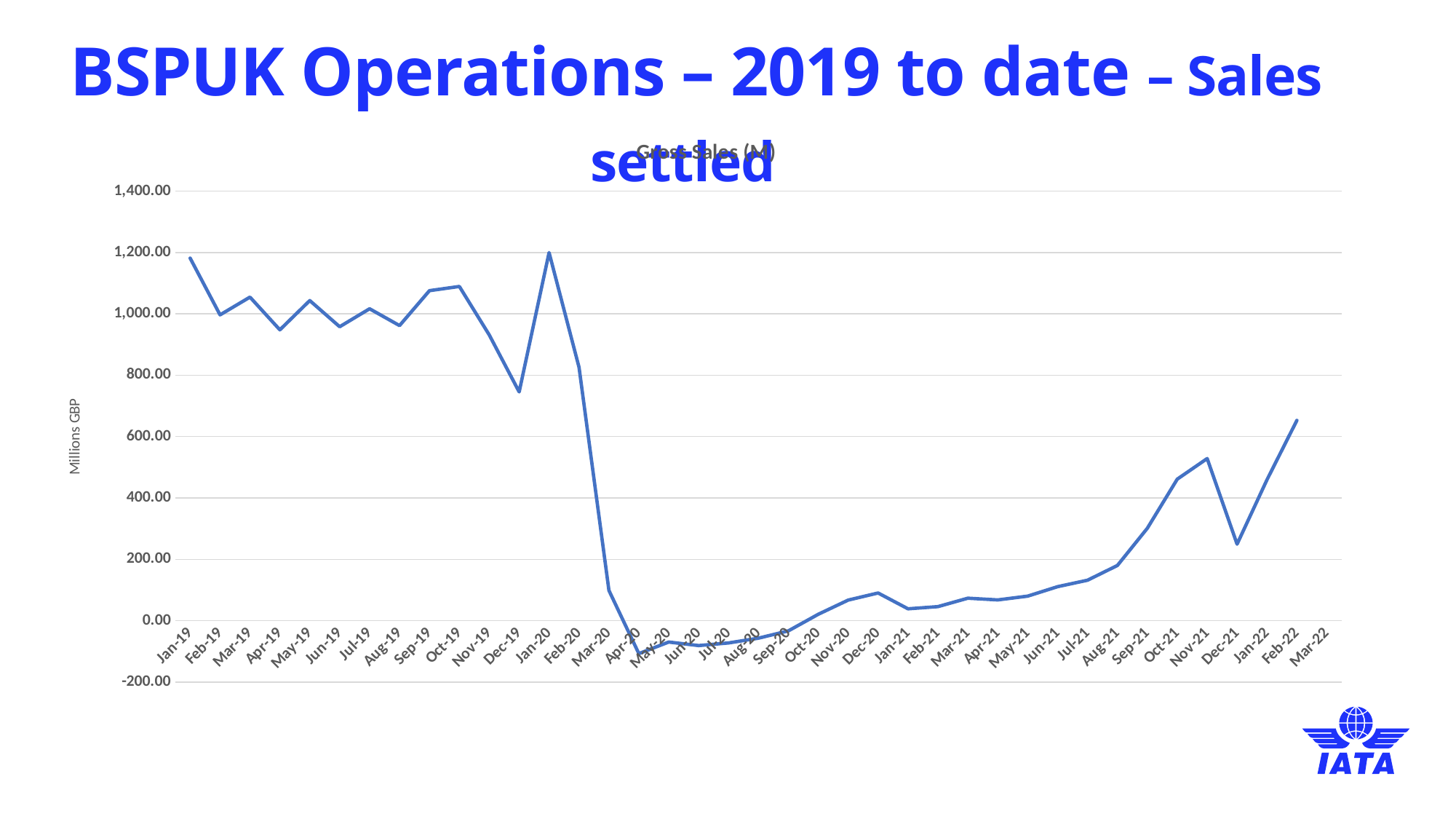
What kind of chart is shown on the slide? line chart Is the value for Dec-19 greater or less than 800.00? less Is the value for Jan-19 greater or less than 1,000.00? greater What is the label on the vertical axis of the chart? Millions GBP Is the value for Feb-22 greater or less than 600.00? greater Which is larger, the value for Jan-19 or the value for Dec-19? Jan-19 Which is larger, the value for Feb-22 or the value for Dec-21? Feb-22 What is the first month shown on the x axis of the chart? Jan-19 Do the values rise or fall from Jan-20 to Apr-20? fall